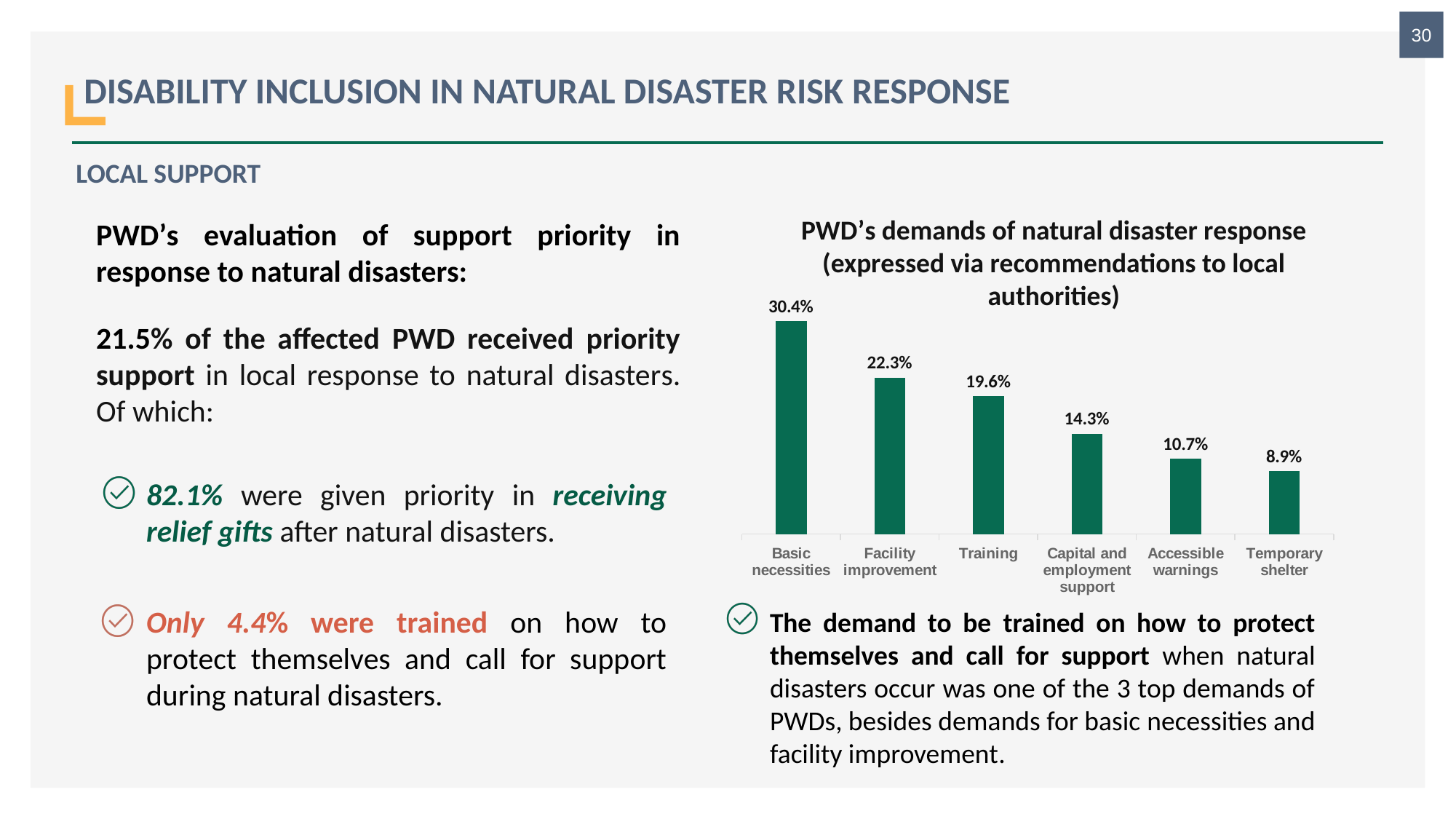
How many categories are shown in the chart? 6 Which category has the lowest value? Temporary shelter What is the difference between Capital and employment support and Accessible warnings? 3.6% Do the values rise or fall from left to right along the x axis? Fall Which category has the highest value? Basic necessities What is the value for Accessible warnings? 10.7% What is the value for Basic necessities? 30.4% What is the value for Training? 19.6% What is the difference between Basic necessities and Facility improvement? 8.1% Which is larger, Facility improvement or Training? Facility improvement What is the value for Temporary shelter? 8.9% What kind of chart is shown? Bar chart